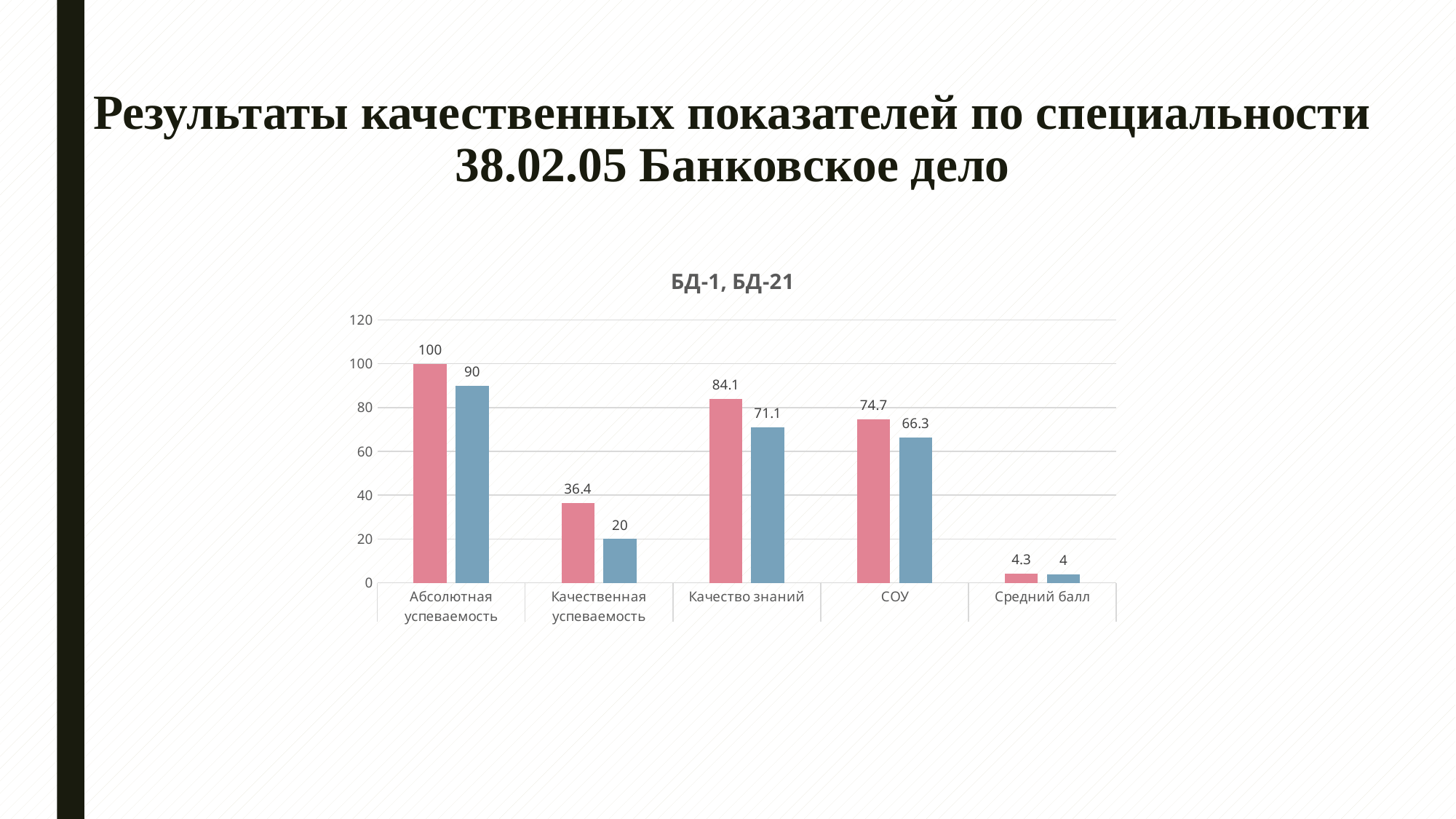
What is the difference between the pink and blue bars for Абсолютная успеваемость? 10 Which is larger for СОУ, the pink bar or the blue bar? the pink bar Which category has the lowest blue bar? Средний балл What is the value of the pink bar for СОУ? 74.7 What kind of chart is shown on the slide? bar chart What is the value of the blue bar for Средний балл? 4 What is the difference between the pink and blue bars for Качественная успеваемость? 16.4 What is the value of the blue bar for Качество знаний? 71.1 What is the value of the pink bar for Абсолютная успеваемость? 100 What is the title of the chart? БД-1, БД-21 Which category has the highest pink bar? Абсолютная успеваемость How many categories are shown on the x axis? 5